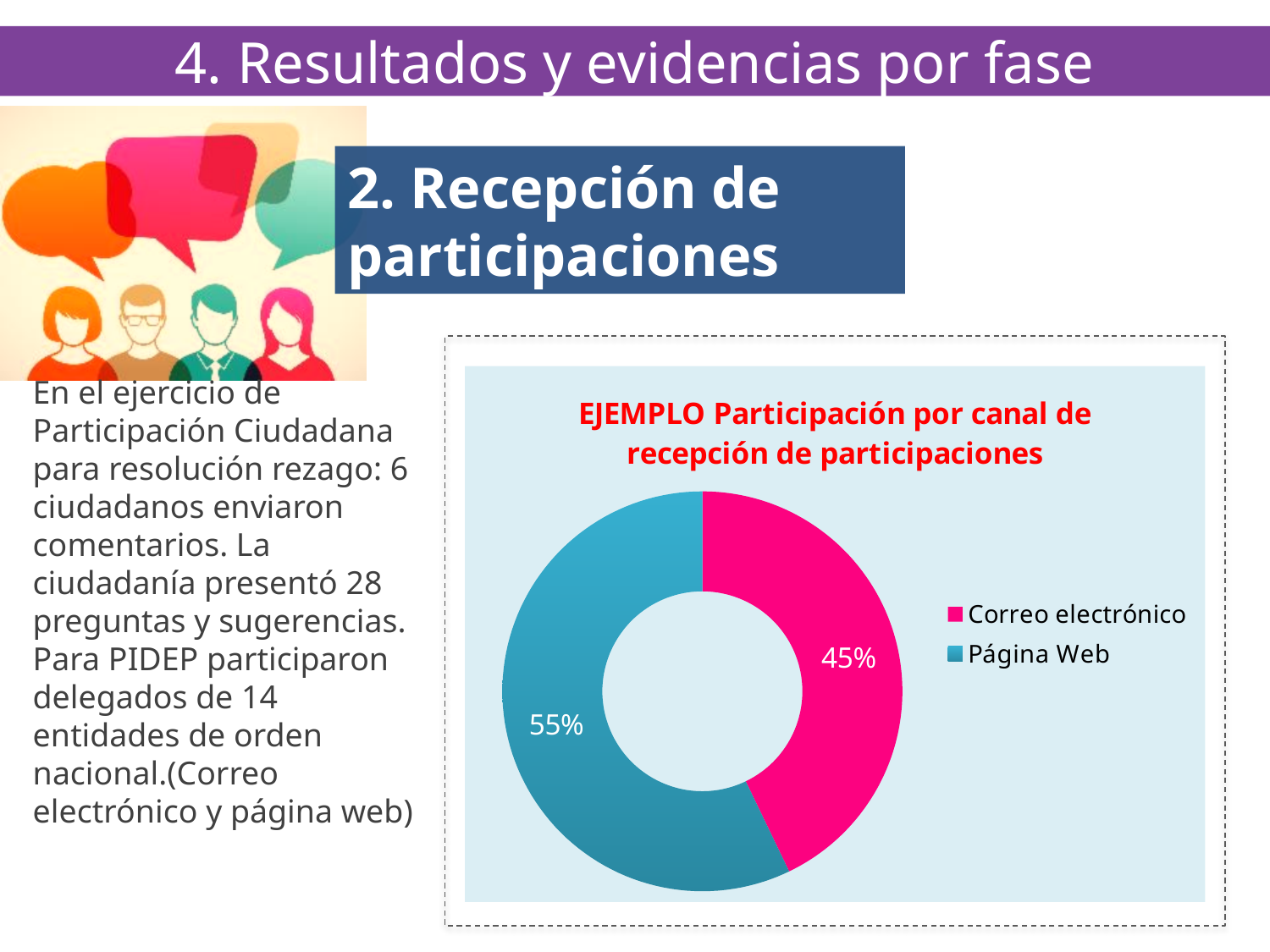
What is the title of the chart? EJEMPLO Participación por canal de recepción de participaciones What share of the pie does Página Web represent? 55% Which category has the smallest share of the pie? Correo electrónico How many entries does the legend list? 2 What kind of chart is shown on the slide? Pie chart (doughnut) What is the difference in percentage points between Página Web and Correo electrónico? 10% What share of the pie does Correo electrónico represent? 45% How many categories are shown in the chart? 2 Which is larger, the share for Correo electrónico or the share for Página Web? Página Web What colour is the Correo electrónico slice? Pink Which category has the largest share of the pie? Página Web